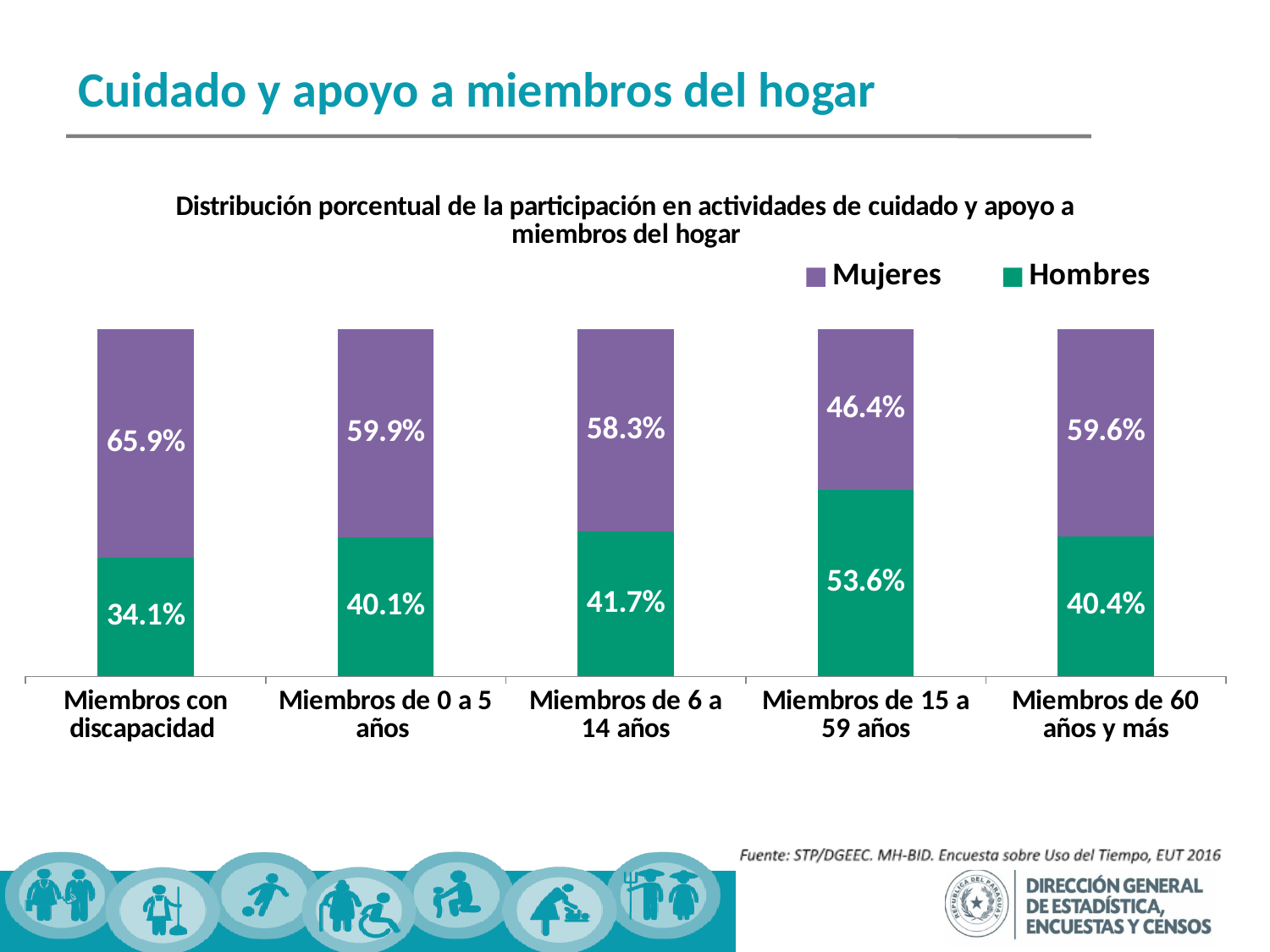
Which category has the highest Mujeres value? Miembros con discapacidad How many series does the legend list? 2 What is the Mujeres value for Miembros de 60 años y más? 59.6% How many categories are shown on the x axis? 5 What is the Hombres value for Miembros con discapacidad? 34.1% What is the Hombres value for Miembros de 6 a 14 años? 41.7% Which category has the highest Hombres value? Miembros de 15 a 59 años What is the difference between the Mujeres and Hombres values for Miembros de 0 a 5 años? 19.8% Which category has the lowest Hombres value? Miembros con discapacidad Is the Mujeres value or the Hombres value larger for Miembros de 15 a 59 años? Hombres What is the Mujeres value for Miembros de 15 a 59 años? 46.4% What kind of chart is shown on the slide? Stacked bar chart